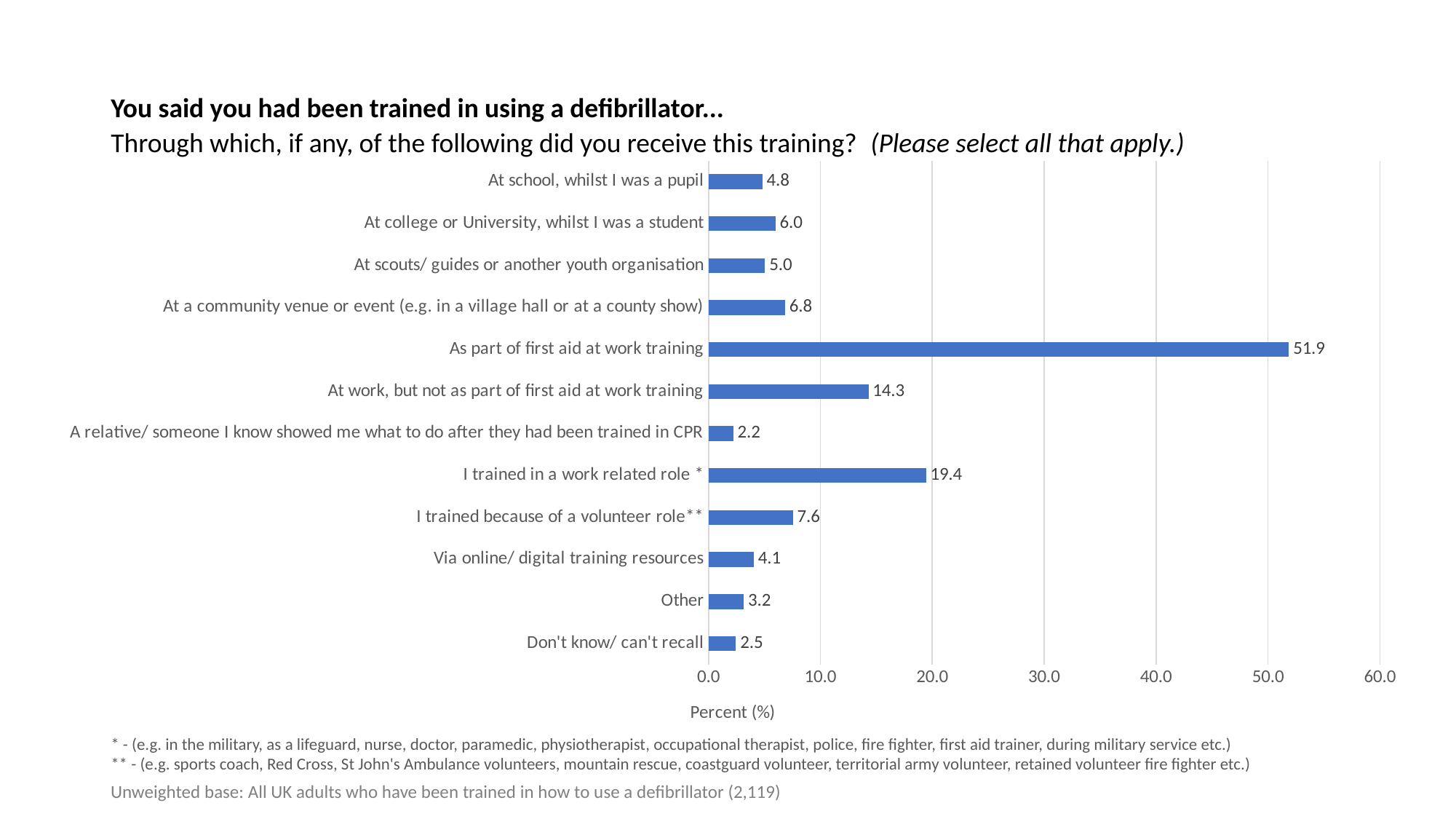
What is the label of the horizontal axis? Percent (%) What percentage of respondents received defibrillator training as part of first aid at work training? 51.9 Which is larger: 'At college or University, whilst I was a student' or 'At scouts/ guides or another youth organisation'? At college or University, whilst I was a student What is the value for 'At work, but not as part of first aid at work training'? 14.3 What is the unweighted base size stated on the slide? 2,119 Which category has the lowest value? A relative/ someone I know showed me what to do after they had been trained in CPR What kind of chart is shown on the slide? Bar chart How many categories are shown in the chart? 12 What percentage received training via online/ digital training resources? 4.1 Is the value for 'As part of first aid at work training' greater or less than 50.0? greater What is the difference between 'I trained in a work related role *' and 'I trained because of a volunteer role**'? 11.8 Which category has the highest value? As part of first aid at work training